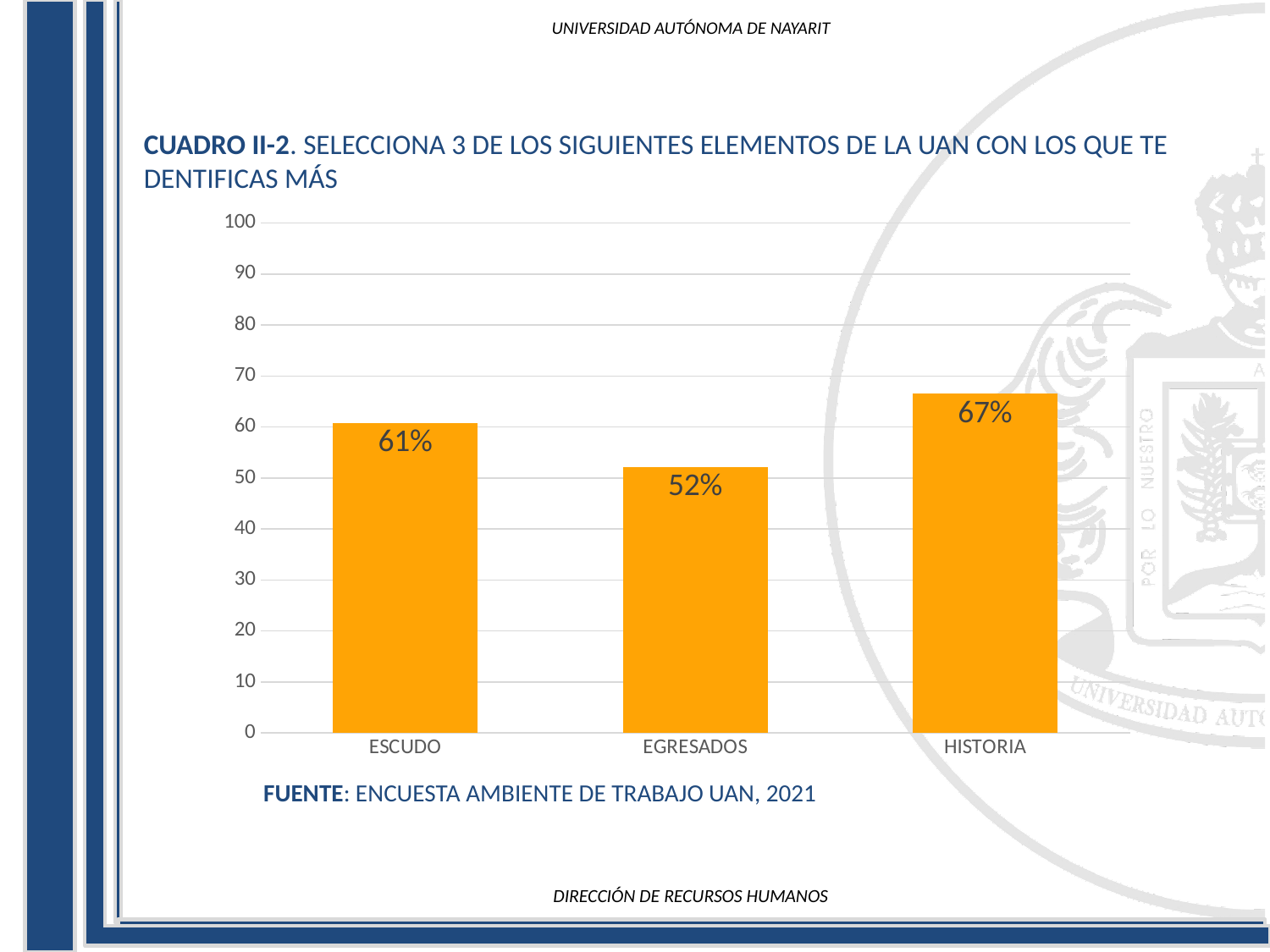
What source is cited below the chart? ENCUESTA AMBIENTE DE TRABAJO UAN, 2021 What kind of chart is shown on the slide? bar chart What is the difference between the values for ESCUDO and EGRESADOS? 9% What is the value for EGRESADOS? 52% Is the value for EGRESADOS greater or less than 60? less Which category has the highest value? HISTORIA How many categories are shown on the x axis? 3 What is the difference between the values for HISTORIA and EGRESADOS? 15% Which category has the lowest value? EGRESADOS Which is larger, the value for ESCUDO or the value for HISTORIA? HISTORIA What is the value for HISTORIA? 67% What is the value for ESCUDO? 61%